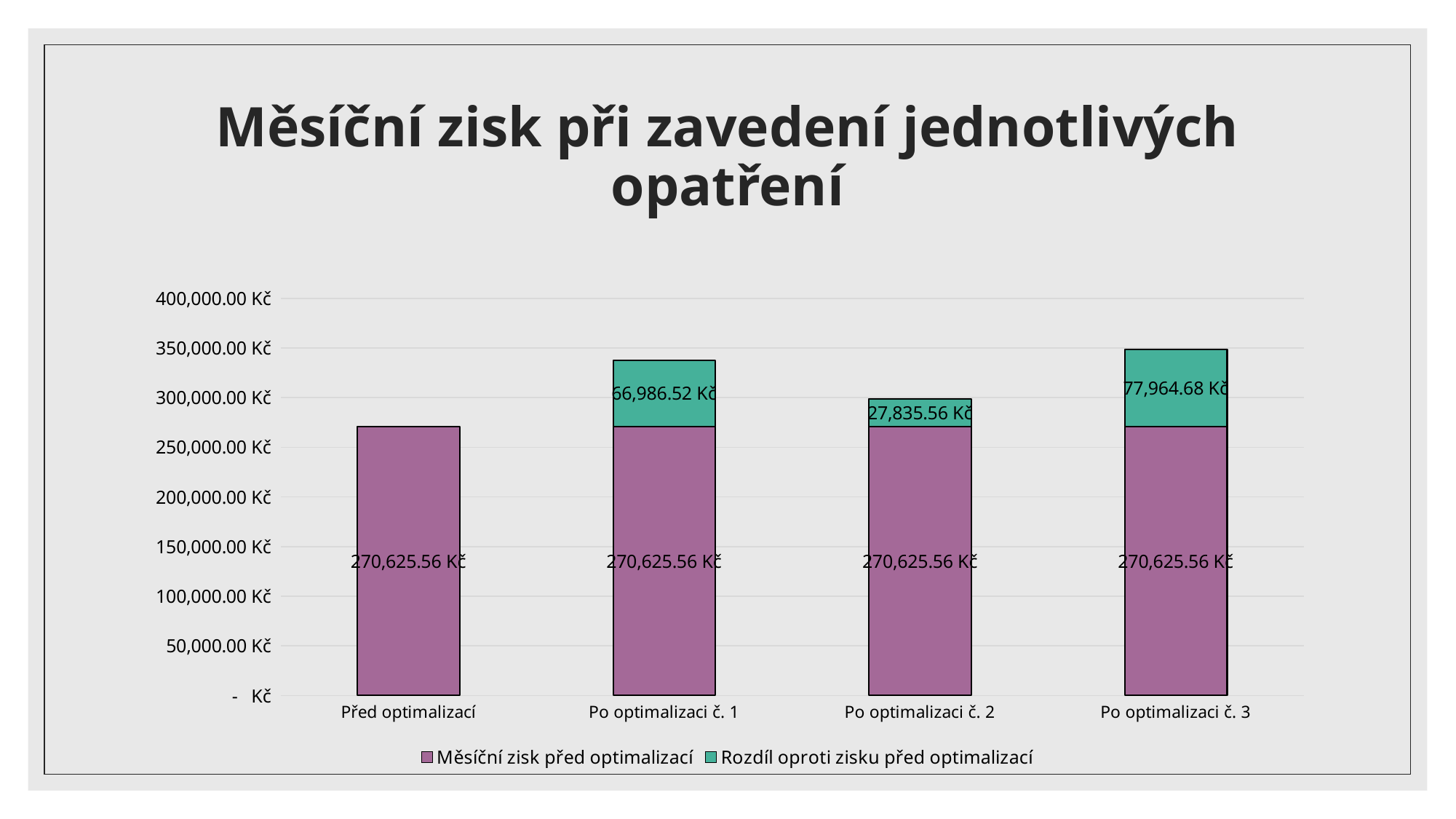
What is the total of the stacked bar for 'Po optimalizaci č. 2'? 298,461.12 Kč What is the difference between the 'Rozdíl oproti zisku před optimalizací' values for 'Po optimalizaci č. 3' and 'Po optimalizaci č. 1'? 10,978.16 Kč What is the value of 'Rozdíl oproti zisku před optimalizací' for 'Po optimalizaci č. 1'? 66,986.52 Kč What is the value of 'Rozdíl oproti zisku před optimalizací' for 'Po optimalizaci č. 2'? 27,835.56 Kč Which category has the lowest total stacked bar? Před optimalizací Which category has the highest value of 'Rozdíl oproti zisku před optimalizací'? Po optimalizaci č. 3 Is the total stacked bar for 'Po optimalizaci č. 3' greater or less than 300,000.00 Kč? greater What is the title of the chart? Měsíční zisk při zavedení jednotlivých opatření What type of chart is shown on the slide? Stacked bar chart How many series does the legend list? 2 How many categories are shown on the x axis? 4 What is the value of 'Měsíční zisk před optimalizací' for 'Před optimalizací'? 270,625.56 Kč